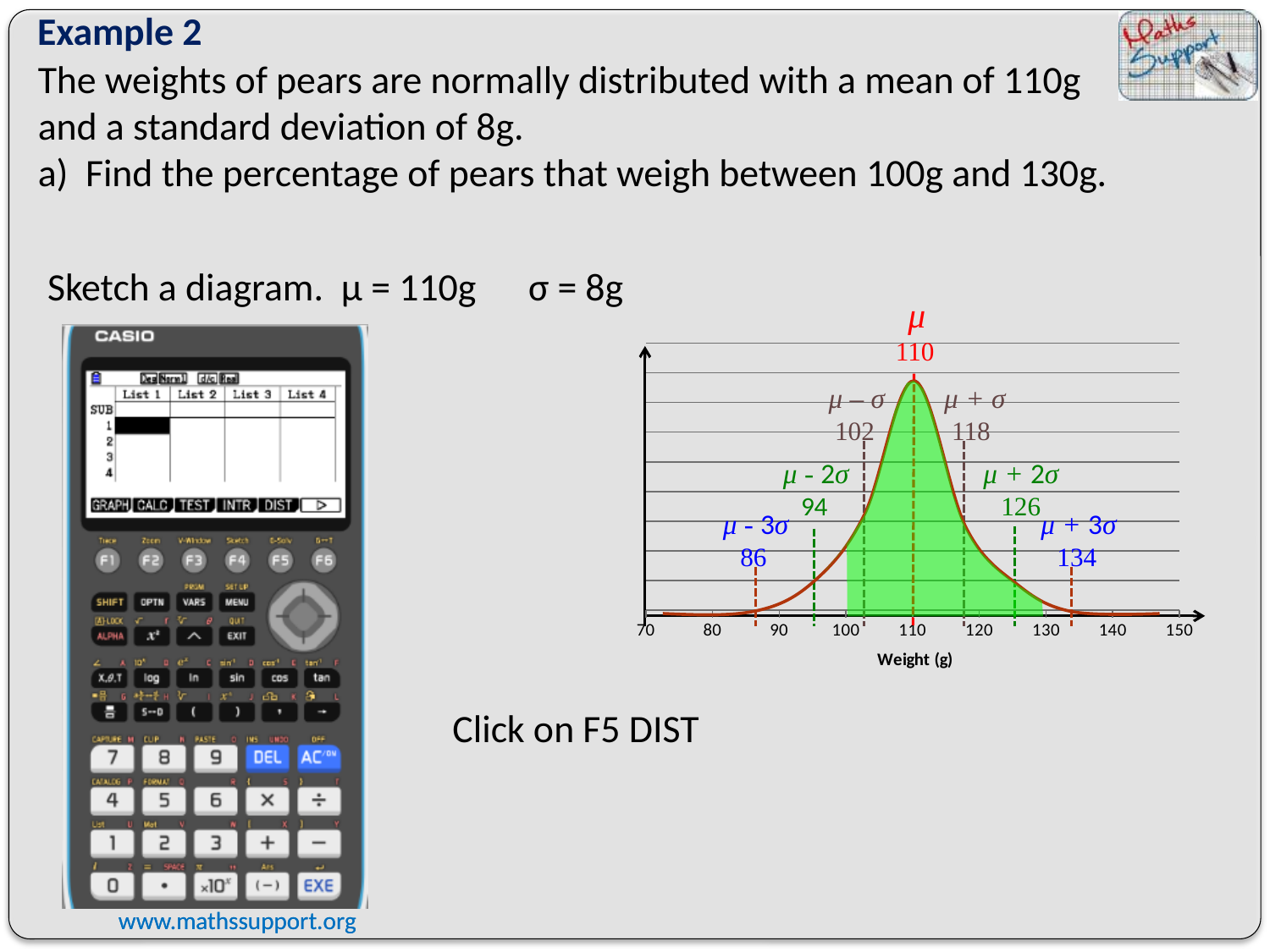
What weight value is labelled at μ + 2σ on the chart? 126 What is the difference between the values labelled at μ + σ and μ − σ? 16 What is the label on the horizontal axis of the chart? Weight (g) What weight value is labelled at μ − σ on the chart? 102 What weight value is labelled at μ on the chart? 110 What weight value is labelled at μ + σ on the chart? 118 What kind of chart is shown on the slide? A normal distribution (bell) curve What weight value is labelled at μ − 3σ on the chart? 86 Between which two weights on the axis is the green shaded region? 100 and 130 What weight value is labelled at μ − 2σ on the chart? 94 What weight value is labelled at μ + 3σ on the chart? 134 At which weight does the curve reach its highest point? 110